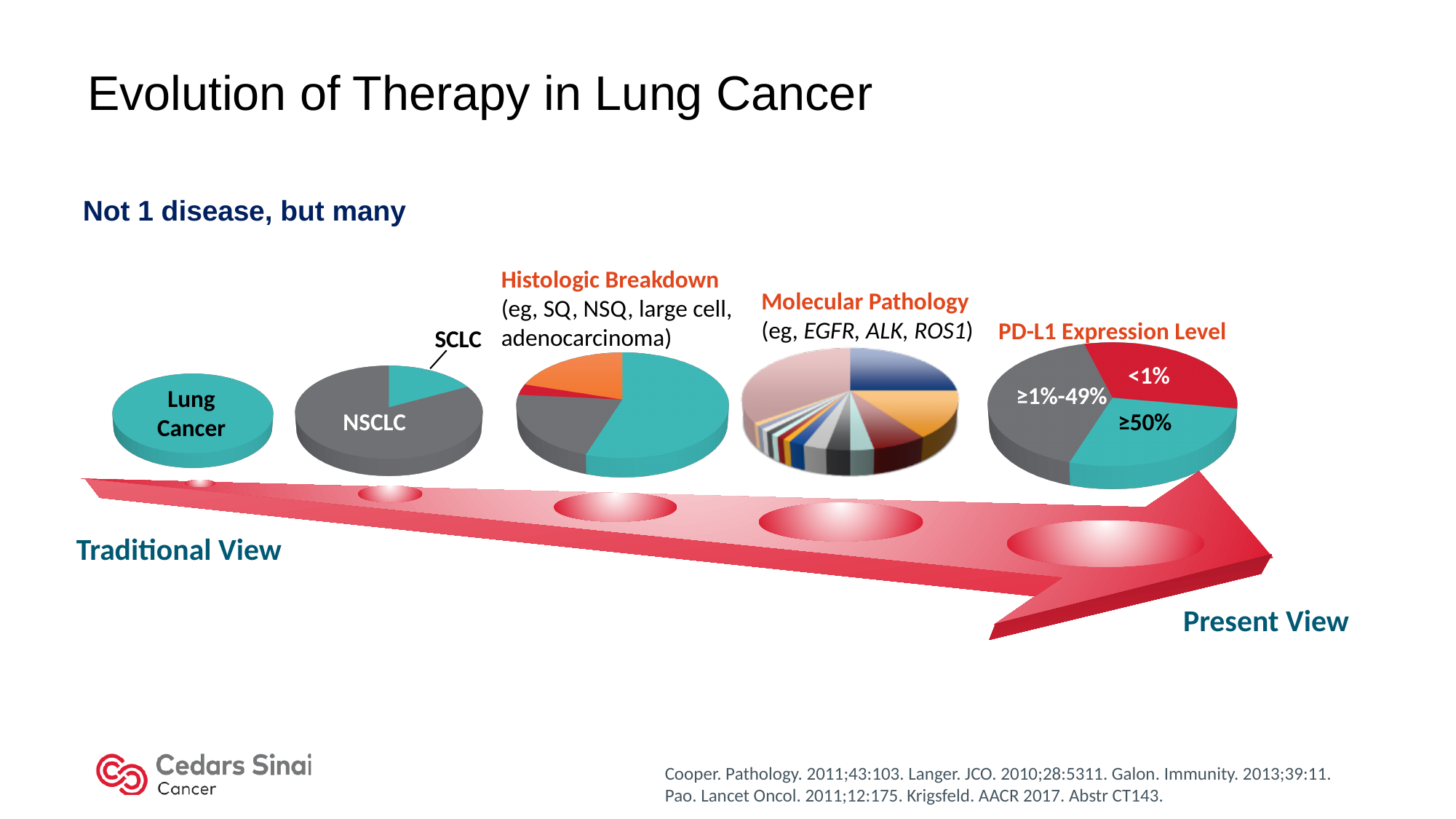
How many pie charts are shown along the arrow on the slide? 5 What label is given to the pie chart with the most slices? Molecular Pathology In the PD-L1 Expression Level pie chart, which slice is larger, <1% or ≥1%-49%? ≥1%-49% How many slices does the first pie chart (Lung Cancer) have? 1 In the second pie chart (NSCLC/SCLC), which slice is larger, NSCLC or SCLC? NSCLC What kind of charts are shown on the slide? Pie charts In the second pie chart, how many slices are there? 2 In the PD-L1 Expression Level pie chart, which slice is the smallest? ≥50% In the PD-L1 Expression Level pie chart, which slice is larger, <1% or ≥50%? <1% What is the title of the pie chart that is furthest to the right? PD-L1 Expression Level